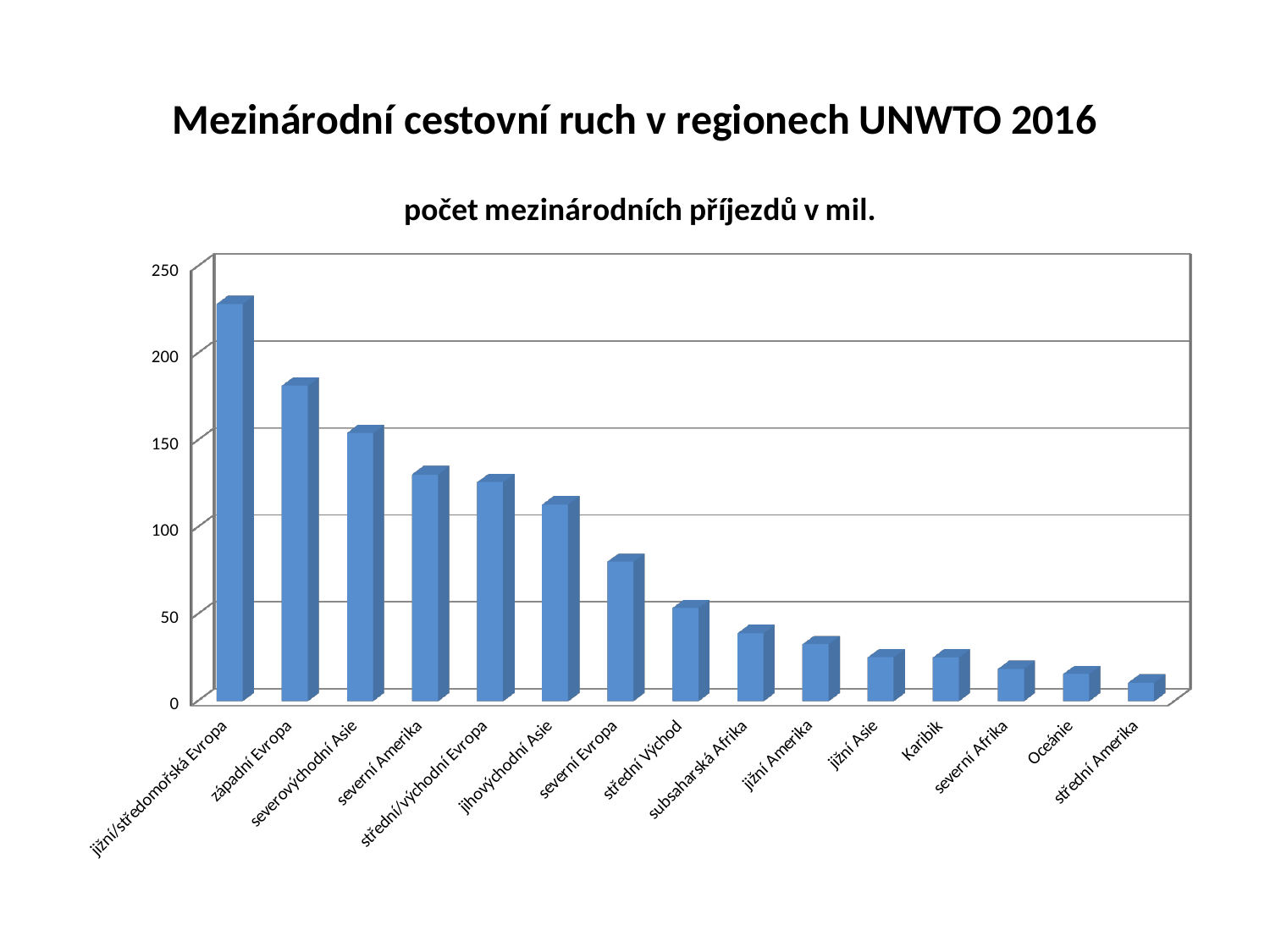
What is the title of the chart? počet mezinárodních příjezdů v mil. Is the value for jižní/středomořská Evropa greater or less than 200? greater Which region has the highest number of international arrivals? jižní/středomořská Evropa How many regions (categories) are plotted in the chart? 15 Is the value for západní Evropa greater or less than 200? less Do the values rise or fall from left to right along the x axis? fall Is the value for severní Evropa greater or less than 100? less Which has more international arrivals, severní Amerika or jihovýchodní Asie? severní Amerika Which region has the lowest number of international arrivals? střední Amerika What kind of chart is shown on the slide? bar chart